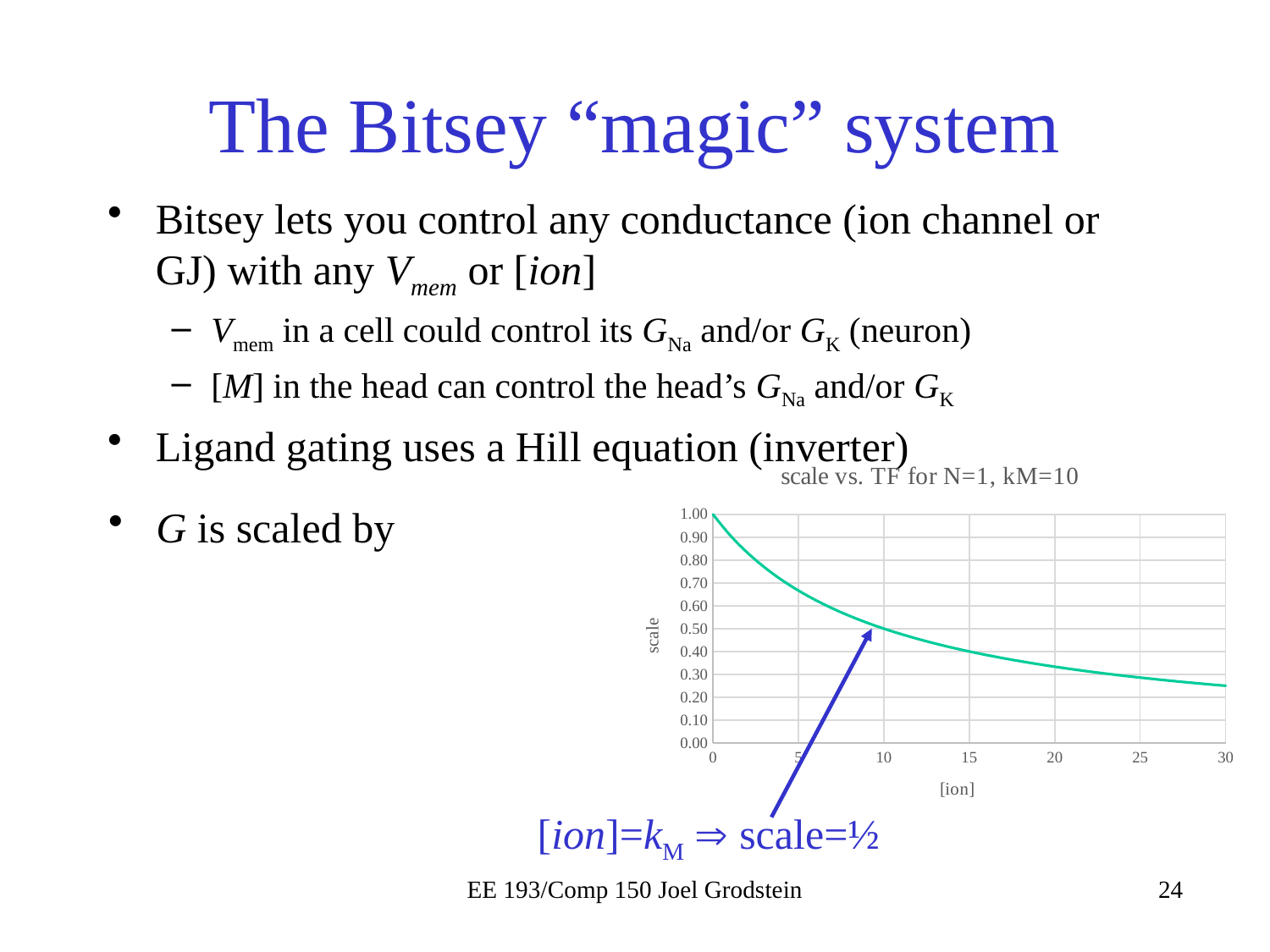
At which [ion] value shown on the x axis is the scale highest? 0 What is the scale value when [ion] is 0? 1.00 What is the title of the chart? scale vs. TF for N=1, kM=10 What kind of chart is shown on the slide? line chart Is the scale value at [ion]=5 greater or less than 0.60? greater Which has the larger scale value, [ion]=5 or [ion]=25? [ion]=5 What is the label of the x axis of the chart? [ion] Is the scale value at [ion]=20 greater or less than 0.40? less Does the scale value rise or fall as [ion] increases along the x axis? fall What is the scale value when [ion] equals kM (10)? 0.50 Is the scale value at [ion]=15 greater or less than 0.50? less